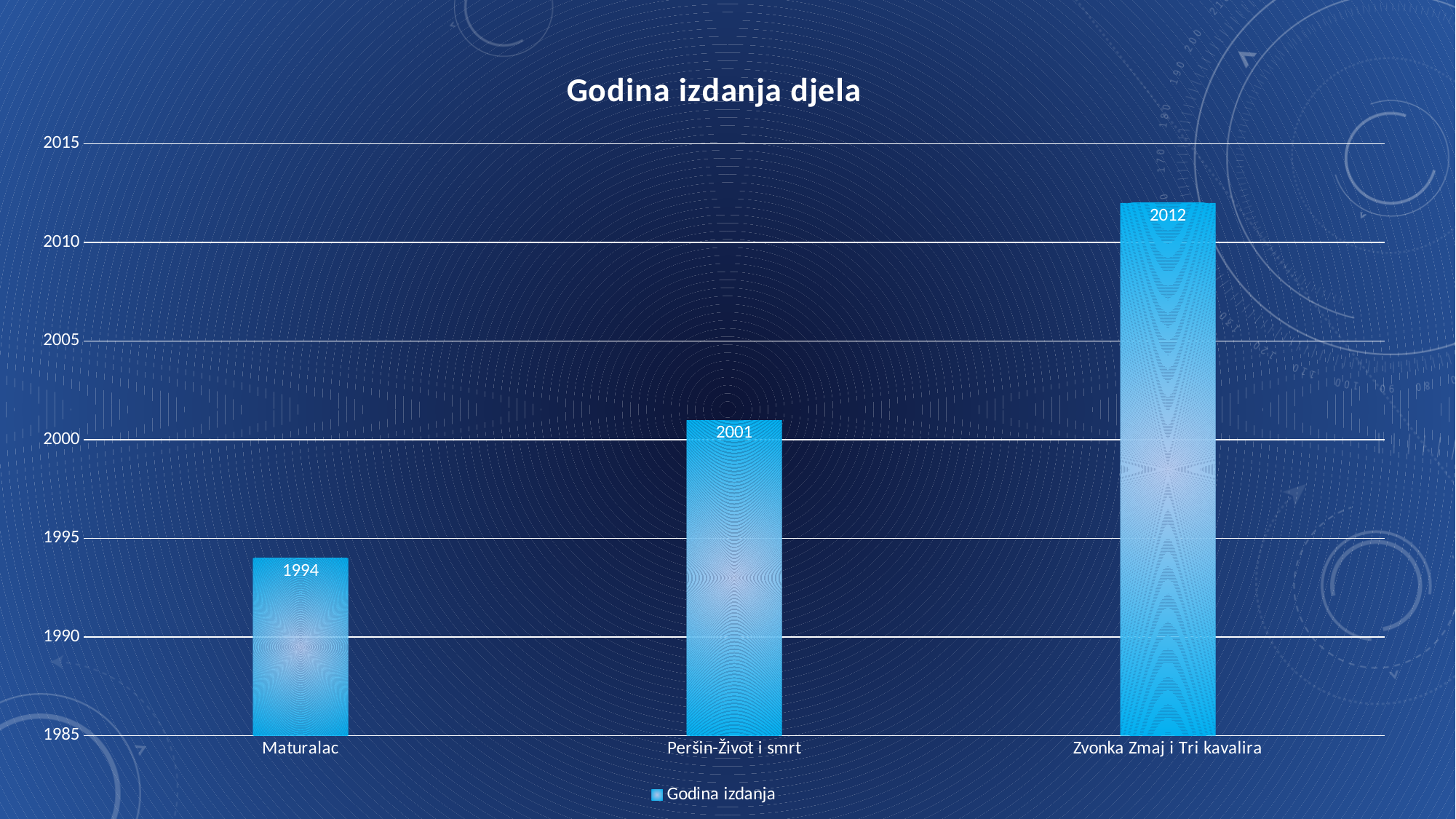
What is the difference between the values for Zvonka Zmaj i Tri kavalira and Maturalac? 18 How many categories are shown on the chart? 3 What is the difference between the values for Peršin-Život i smrt and Maturalac? 7 What kind of chart is shown on the slide? bar chart What is the value for Maturalac? 1994 What is the value for Peršin-Život i smrt? 2001 What is the title of the chart? Godina izdanja djela Which category has the lowest value? Maturalac What is the value for Zvonka Zmaj i Tri kavalira? 2012 Is the value for Peršin-Život i smrt greater or less than 2005? less Which category has the highest value? Zvonka Zmaj i Tri kavalira Which is larger, the value for Peršin-Život i smrt or the value for Maturalac? Peršin-Život i smrt